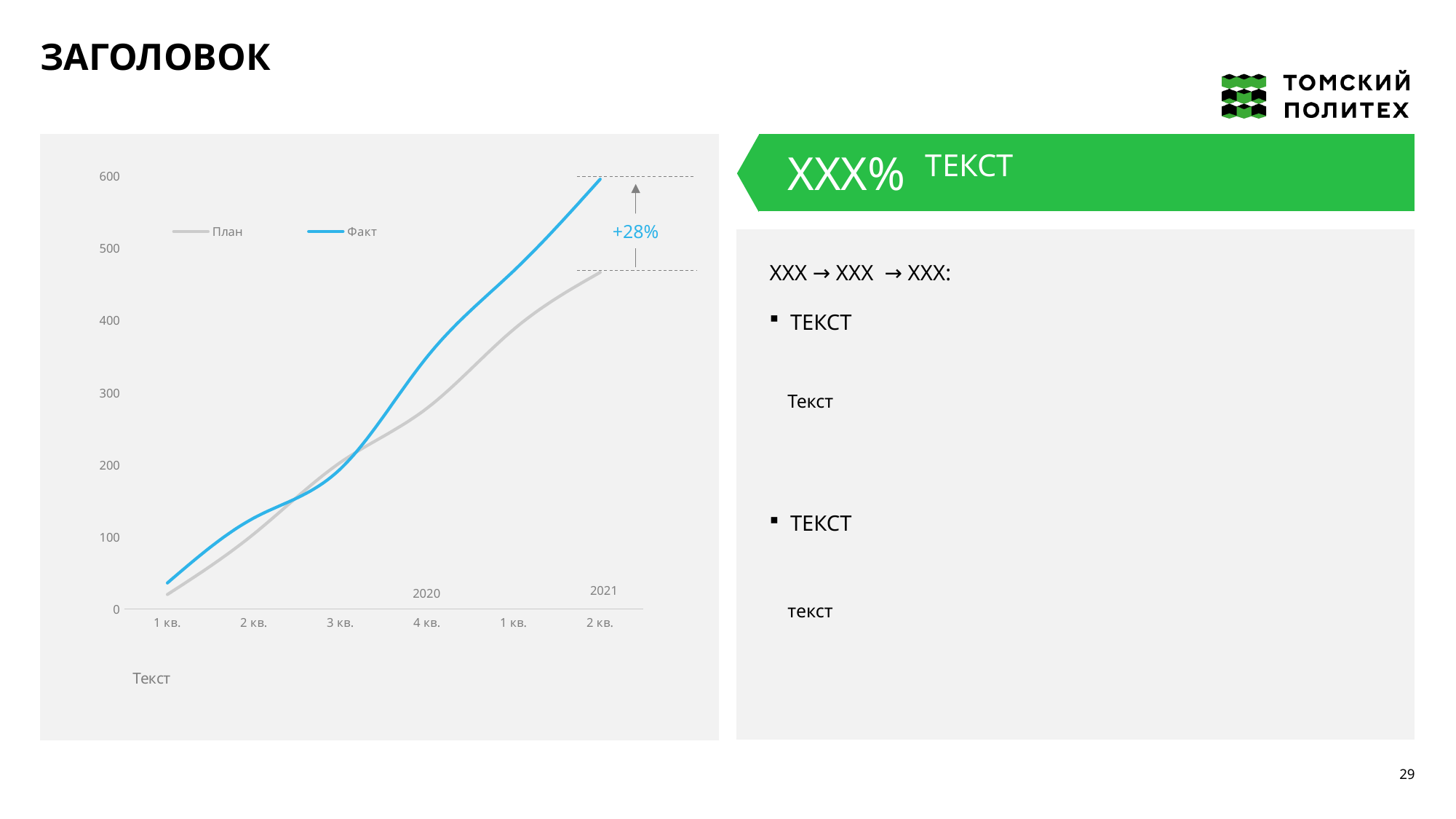
How many quarters are shown along the x axis of the chart? 6 At 2 кв. 2021, which series has the higher value, План or Факт? Факт What percentage change is annotated between the two lines at the right end of the chart? +28% What are the two series named in the chart legend? План and Факт How many series does the chart legend list? 2 Is the value for План at 4 кв. 2020 greater or less than 300? less Does the Факт line rise or fall from 1 кв. 2020 to 2 кв. 2021? rise Does the План line rise or fall across the x axis? rise Is the value for План at 2 кв. 2021 greater or less than 500? less Is the value for Факт at 1 кв. 2020 greater or less than 100? less What kind of chart is shown on the slide? line chart